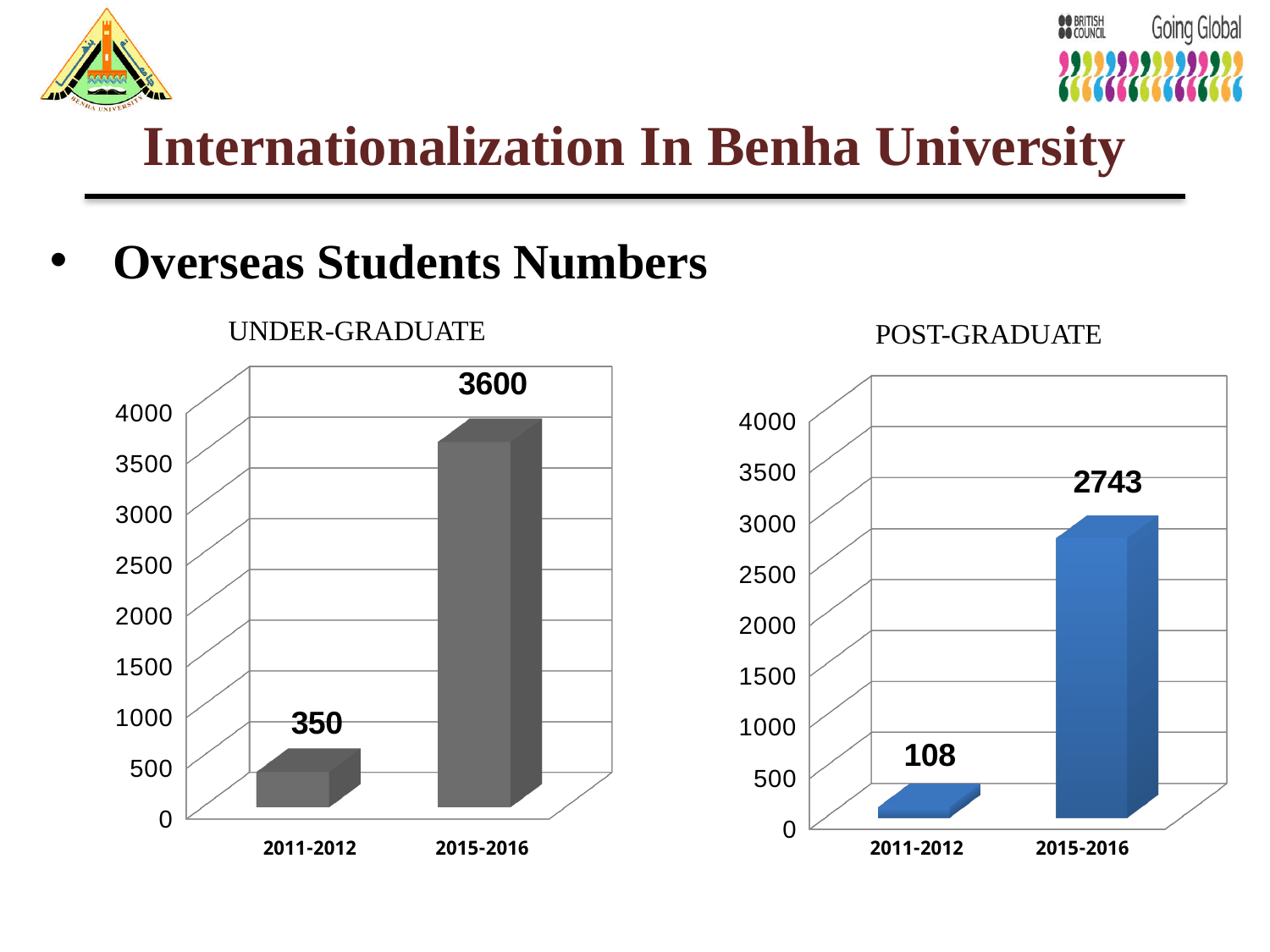
In the UNDER-GRADUATE chart, what is the difference between the 2015-2016 and 2011-2012 values? 3250 In the POST-GRADUATE chart, what is the value for 2015-2016? 2743 In the POST-GRADUATE chart, what is the difference between the 2015-2016 and 2011-2012 values? 2635 In the UNDER-GRADUATE chart, what is the value for 2011-2012? 350 In the POST-GRADUATE chart, do the values rise or fall from 2011-2012 to 2015-2016? Rise In the UNDER-GRADUATE chart, which category has the highest value? 2015-2016 In the POST-GRADUATE chart, what is the value for 2011-2012? 108 How many categories are shown on the x axis of the POST-GRADUATE chart? 2 In the UNDER-GRADUATE chart, what is the value for 2015-2016? 3600 In the POST-GRADUATE chart, which category has the lowest value? 2011-2012 Which is larger: the 2015-2016 value in the UNDER-GRADUATE chart or the 2015-2016 value in the POST-GRADUATE chart? UNDER-GRADUATE What kind of chart is the UNDER-GRADUATE chart? Bar chart